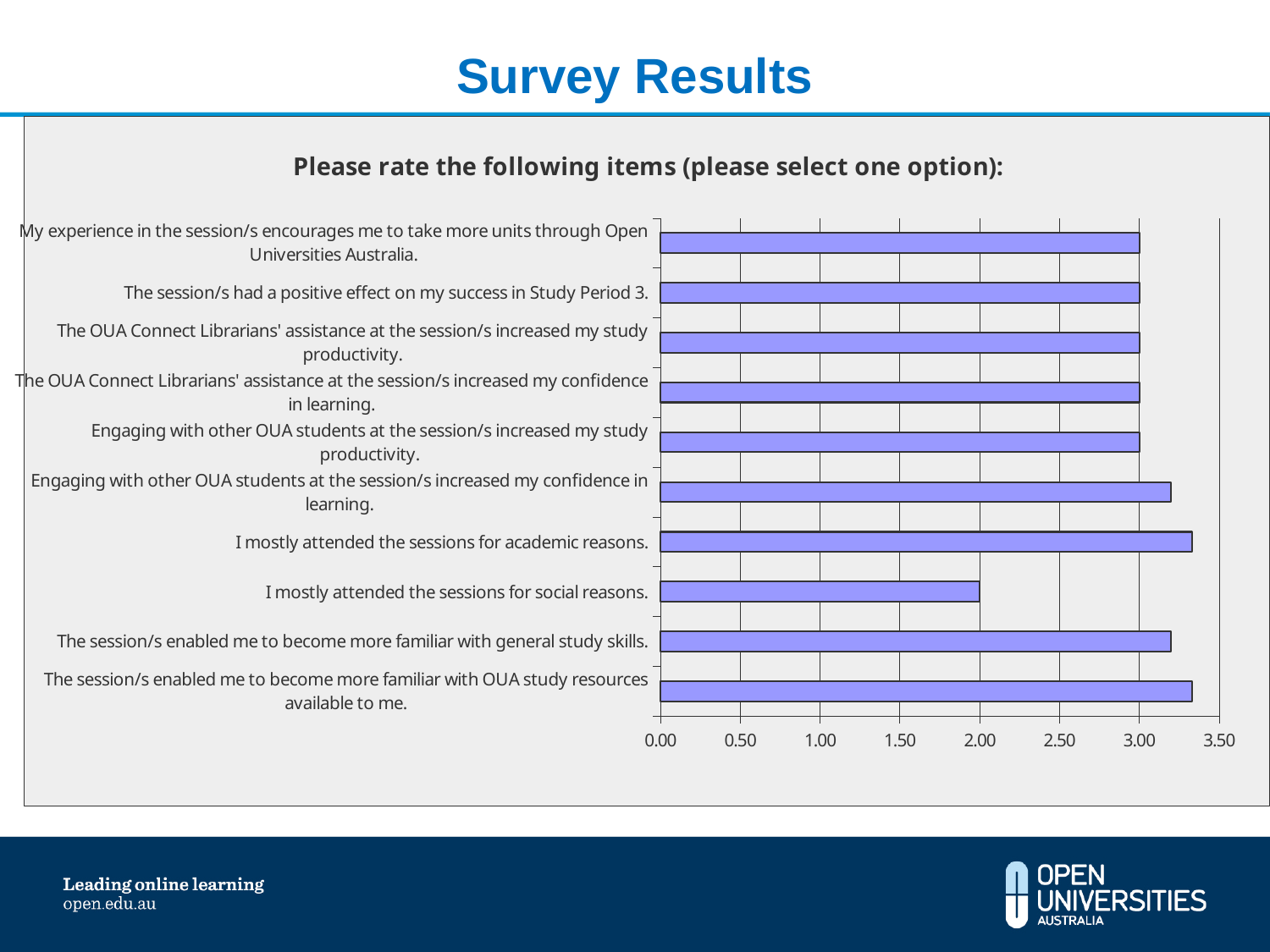
Is the rating for "I mostly attended the sessions for academic reasons." greater or less than 3.00? greater What type of chart is shown on the slide? bar chart Is the rating for "The session/s enabled me to become more familiar with general study skills." greater or less than 3.00? greater What is the rating for "My experience in the session/s encourages me to take more units through Open Universities Australia."? 3.00 What is the title of the chart? Please rate the following items (please select one option): Is the rating for "I mostly attended the sessions for social reasons." greater or less than 2.50? less What is the rating for "I mostly attended the sessions for social reasons."? 2.00 What is the rating for "The session/s had a positive effect on my success in Study Period 3."? 3.00 How many items (categories) are plotted in the chart? 10 Which item has the lowest rating in the chart? I mostly attended the sessions for social reasons. What is the difference between the rating for "The session/s had a positive effect on my success in Study Period 3." and the rating for "I mostly attended the sessions for social reasons."? 1.00 Which is larger: the rating for attending the sessions for academic reasons or for social reasons? academic reasons